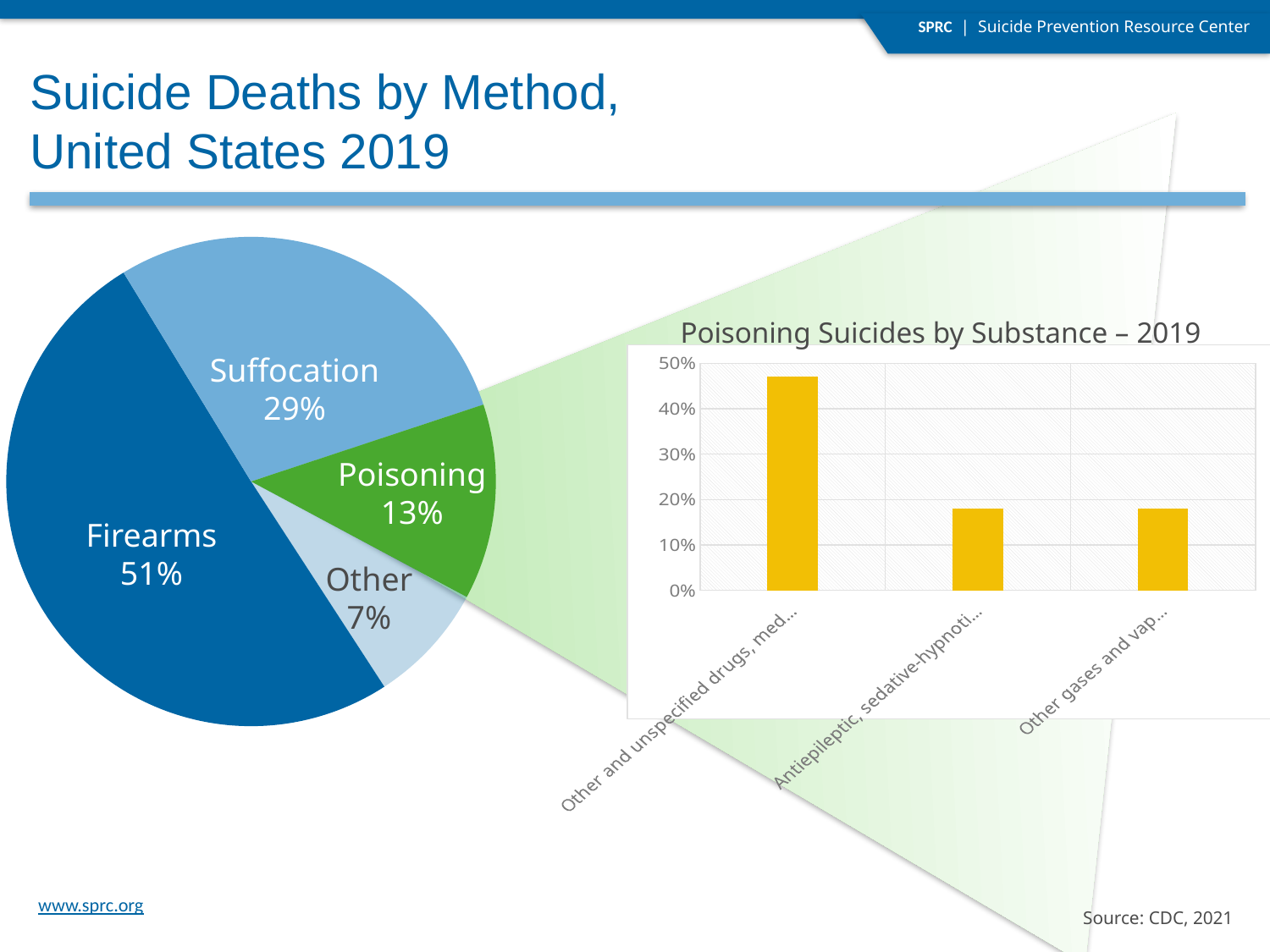
In the pie chart on the left, which category has the smallest share? Other In the pie chart on the left, what share of suicide deaths is attributed to Firearms? 51% How many slices does the pie chart on the left have? 4 What type of chart is the 'Poisoning Suicides by Substance – 2019' chart on the right? Bar chart In the pie chart on the left, what percentage is shown for Poisoning? 13% In the 'Poisoning Suicides by Substance – 2019' chart, which substance category has the highest bar? Other and unspecified drugs, med... In the pie chart on the left, which is larger, the share for Poisoning or the share for Other? Poisoning How many bars are shown in the 'Poisoning Suicides by Substance – 2019' chart? 3 In the pie chart on the left, what percentage is shown for Suffocation? 29% In the pie chart on the left, what is the difference in percentage points between Firearms and Suffocation? 22 In the pie chart on the left, which method accounts for the largest share of suicide deaths? Firearms In the 'Poisoning Suicides by Substance – 2019' chart, is the value for the first bar (Other and unspecified drugs) greater or less than 40%? greater